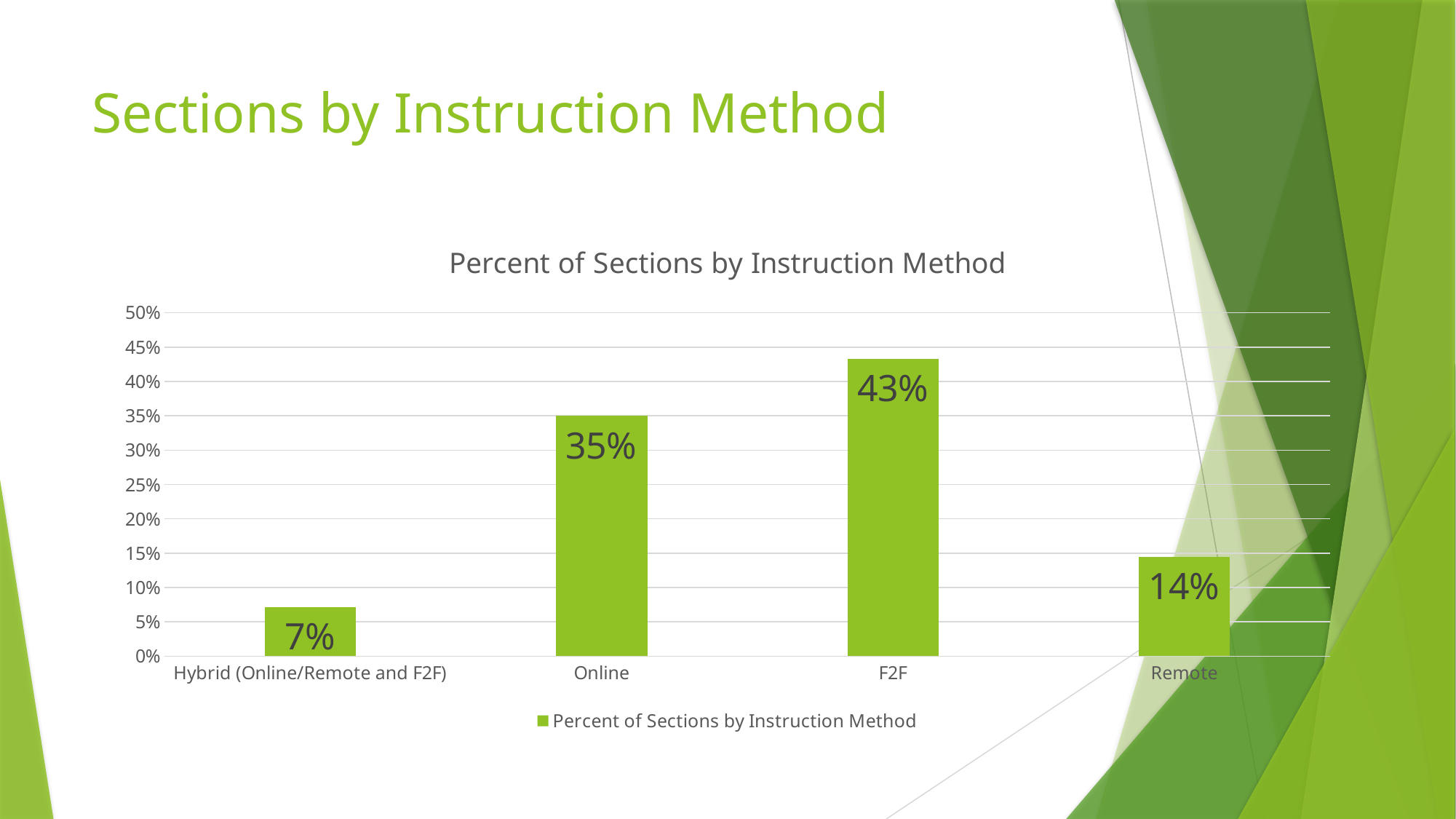
What is the difference between the values for F2F and Online? 8% What is the value for Hybrid (Online/Remote and F2F)? 7% What is the value for Remote? 14% What is the title of the chart? Percent of Sections by Instruction Method Which is larger, the value for Online or the value for Remote? Online How many categories are shown on the x axis? 4 Is the value for F2F greater or less than 40%? greater What is the difference between the values for Remote and Hybrid (Online/Remote and F2F)? 7% Which instruction method has the highest percent of sections? F2F What kind of chart is shown on the slide? Bar chart Which instruction method has the lowest percent of sections? Hybrid (Online/Remote and F2F) What is the value for Online? 35%